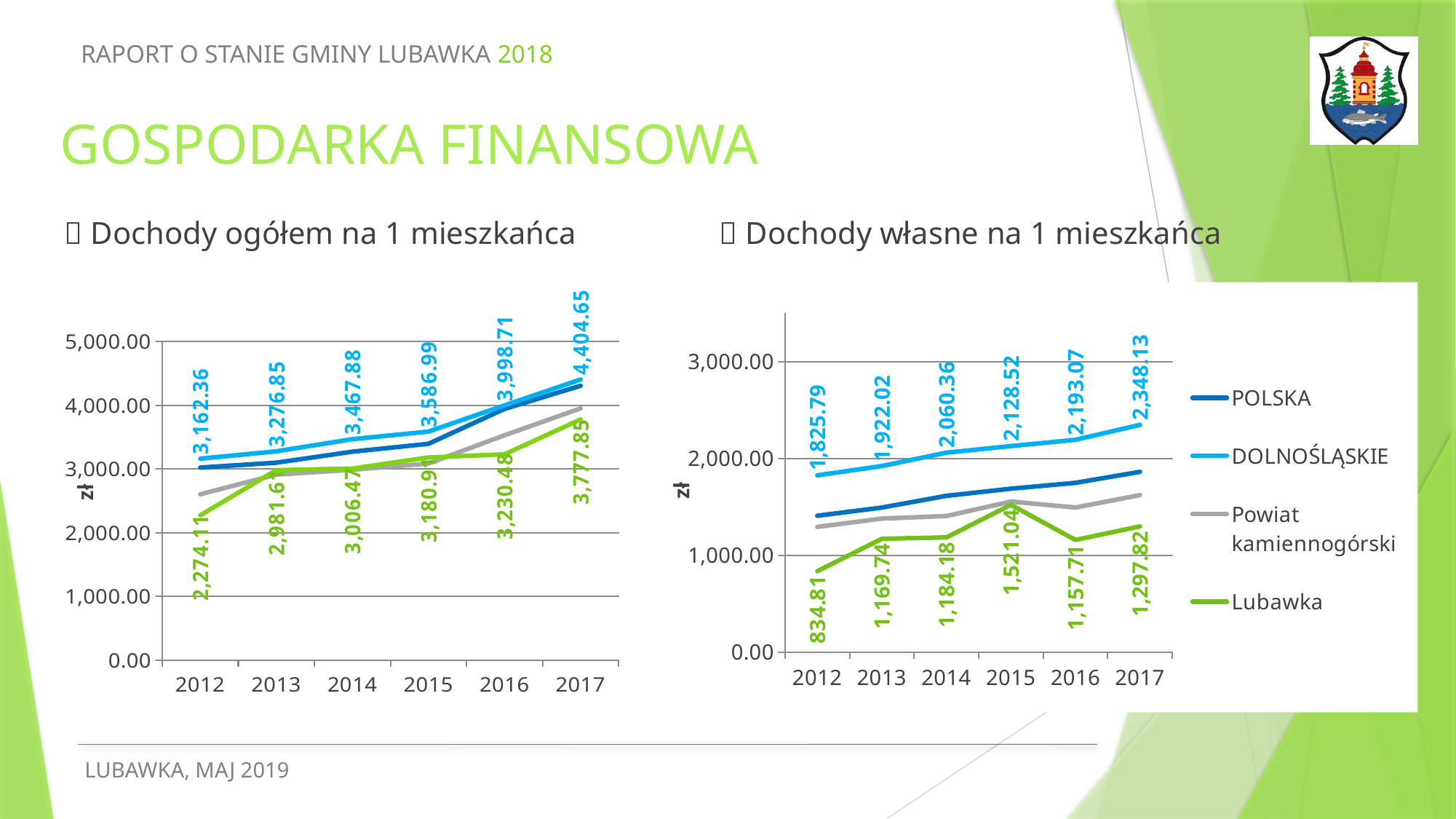
In the 'Dochody własne na 1 mieszkańca' chart, is the POLSKA value in 2017 greater or less than 2,000.00? less In the 'Dochody własne na 1 mieszkańca' chart, in which year is the Lubawka value highest? 2015 How many series does the legend list? 4 In the 'Dochody ogółem na 1 mieszkańca' chart, which is larger in 2016: the DOLNOŚLĄSKIE value or the Lubawka value? DOLNOŚLĄSKIE In the 'Dochody ogółem na 1 mieszkańca' chart, does the DOLNOŚLĄSKIE line rise or fall from 2012 to 2017? rise In the 'Dochody własne na 1 mieszkańca' chart, what is the value for DOLNOŚLĄSKIE in 2014? 2,060.36 In the 'Dochody ogółem na 1 mieszkańca' chart, what is the value for DOLNOŚLĄSKIE in 2017? 4,404.65 In the 'Dochody własne na 1 mieszkańca' chart, what is the value for Lubawka in 2015? 1,521.04 In the 'Dochody ogółem na 1 mieszkańca' chart, what is the value for Lubawka in 2012? 2,274.11 In the 'Dochody własne na 1 mieszkańca' chart, in which year is the Lubawka value lowest? 2012 What kind of chart is the 'Dochody ogółem na 1 mieszkańca' chart? line chart In the 'Dochody własne na 1 mieszkańca' chart, what is the difference between the DOLNOŚLĄSKIE value and the Lubawka value in 2012? 990.98